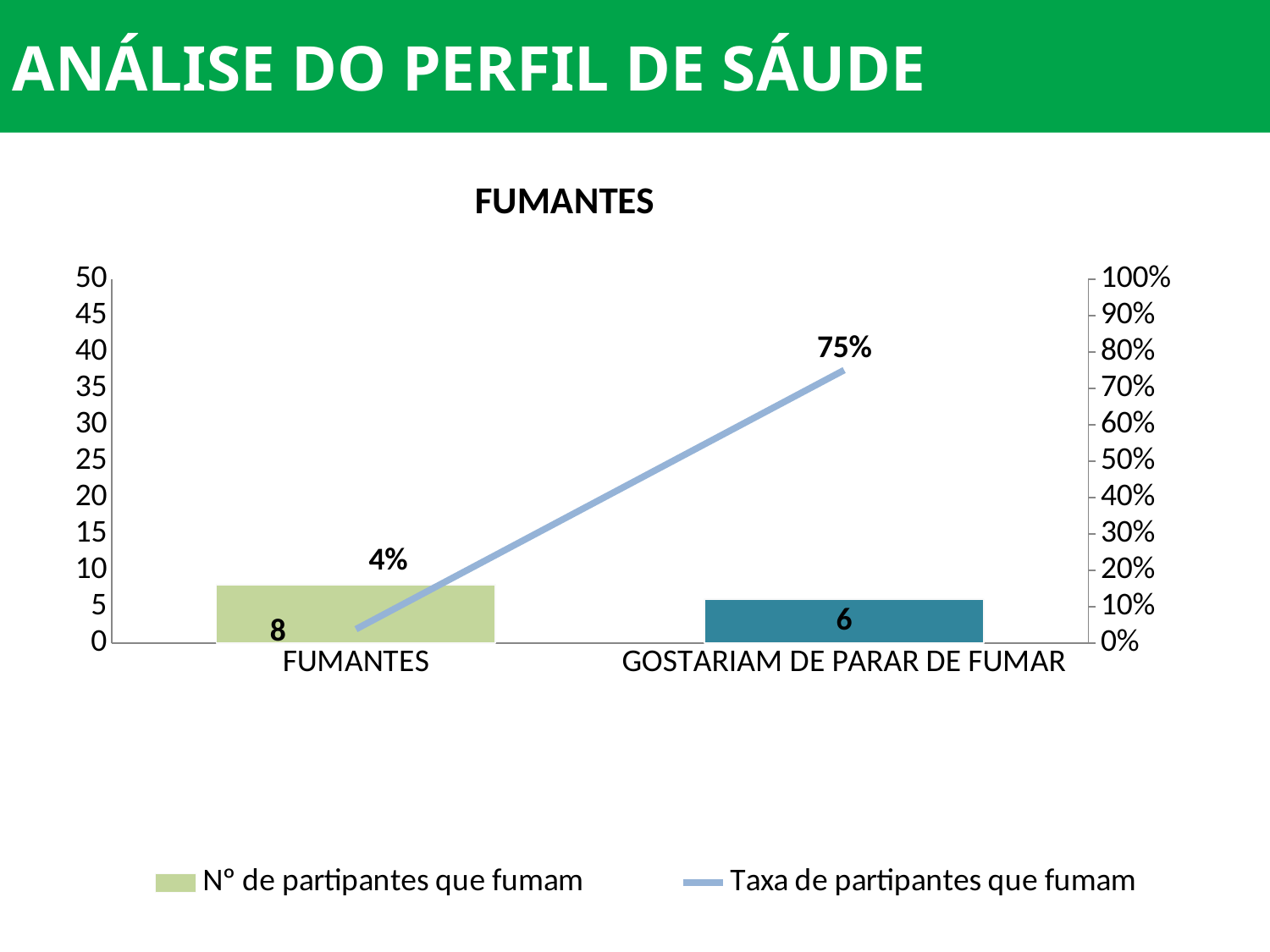
What is the rate (Taxa de partipantes que fumam) shown for the GOSTARIAM DE PARAR DE FUMAR category? 75% What is the number of participants shown for the FUMANTES category? 8 What is the difference between the bar values for FUMANTES and GOSTARIAM DE PARAR DE FUMAR? 2 What is the rate (Taxa de partipantes que fumam) shown for the FUMANTES category? 4% Is the rate for GOSTARIAM DE PARAR DE FUMAR larger or smaller than the rate for FUMANTES? larger Which category has the lower rate on the line series? FUMANTES How many series does the legend list? 2 Does the line series rise or fall from FUMANTES to GOSTARIAM DE PARAR DE FUMAR? rise What is the number of participants shown for the GOSTARIAM DE PARAR DE FUMAR category? 6 How many categories are shown on the x axis? 2 Which category has the higher bar value? FUMANTES What is the title of the chart? FUMANTES